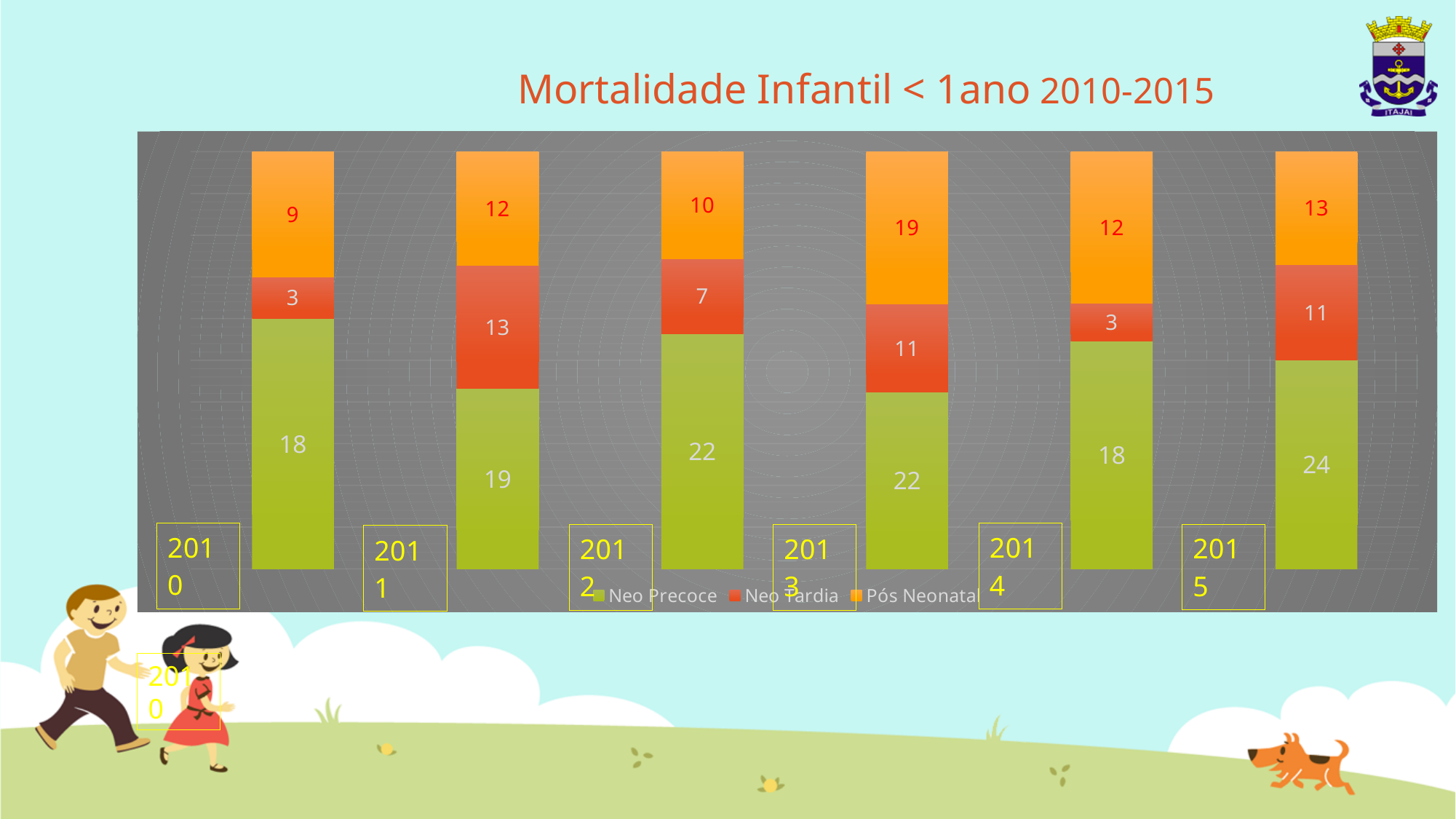
What is the total of the stacked bar for 2010? 30 What is the Neo Tardia value for 2011? 13 How many series does the legend list? 3 Which is larger, the Pós Neonatal value for 2013 or for 2014? 2013 What is the difference between the Neo Tardia values for 2011 and 2010? 10 How many years are shown on the x axis? 6 What is the Neo Precoce value for 2015? 24 What is the total of the stacked bar for 2013? 52 Which year has the lowest Pós Neonatal value? 2010 What is the Pós Neonatal value for 2013? 19 What kind of chart is shown on the slide? Stacked bar chart Which year has the highest Neo Precoce value? 2015